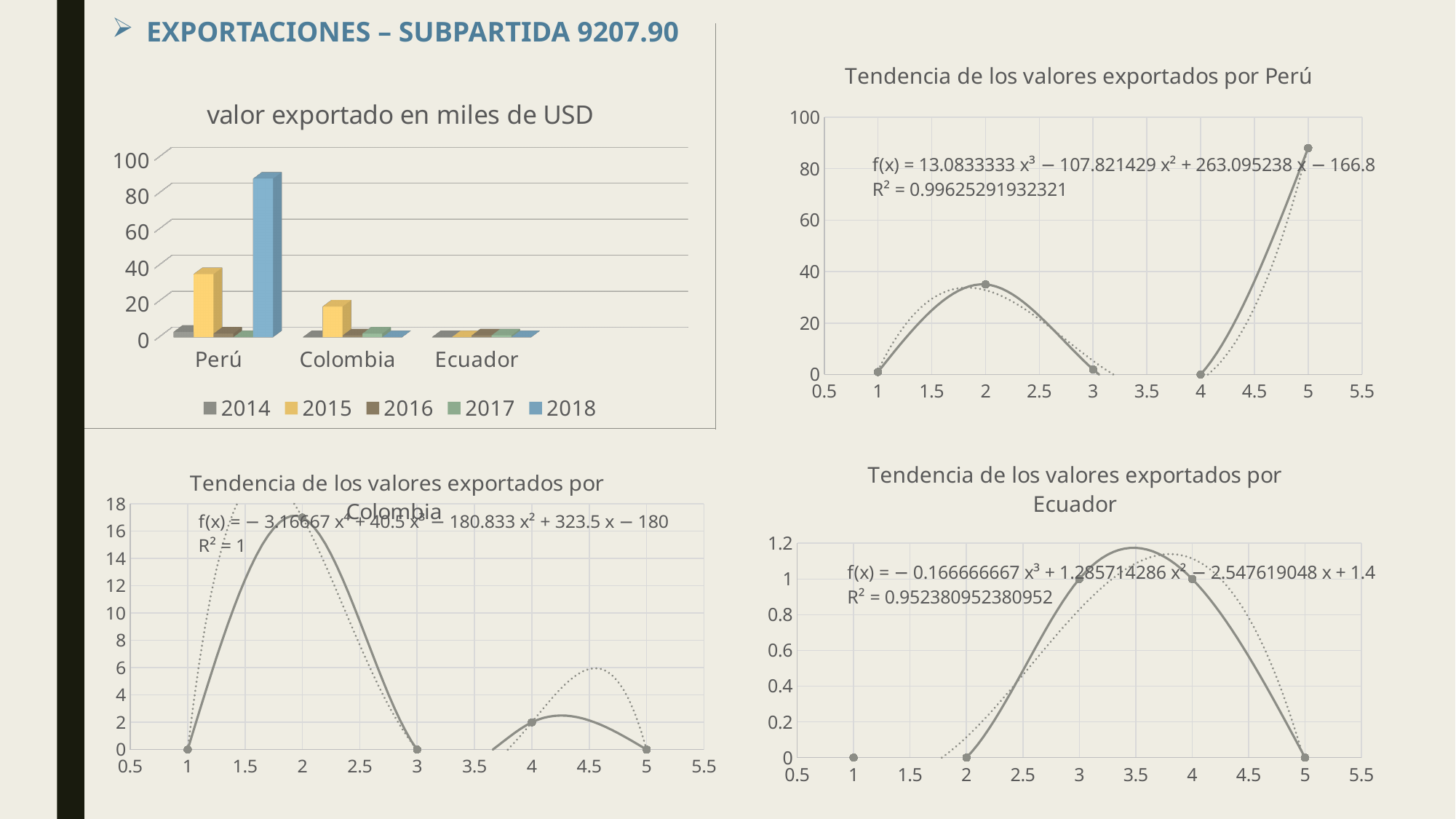
In the 'Tendencia de los valores exportados por Perú' chart, is the plotted value at x = 5 greater or less than 80? greater In the 'Tendencia de los valores exportados por Perú' chart, what is the plotted value at x = 4? 0 In the 'valor exportado en miles de USD' chart, is the 2015 value for Colombia greater or less than 20? less How many countries are shown on the x axis of the 'valor exportado en miles de USD' chart? 3 In the 'valor exportado en miles de USD' chart, which country has the tallest bar? Perú In the 'valor exportado en miles de USD' chart, which is larger for Perú: the 2015 value or the 2018 value? 2018 In the 'Tendencia de los valores exportados por Colombia' chart, what is the plotted value at x = 4? 2 What kind of chart is the 'valor exportado en miles de USD' chart? bar chart In the 'valor exportado en miles de USD' chart, is the 2018 value for Perú greater or less than 80? greater How many series does the legend of the 'valor exportado en miles de USD' chart list? 5 In the 'Tendencia de los valores exportados por Ecuador' chart, what is the plotted value at x = 3? 1 What R² value is shown on the 'Tendencia de los valores exportados por Ecuador' chart? 0.952380952380952